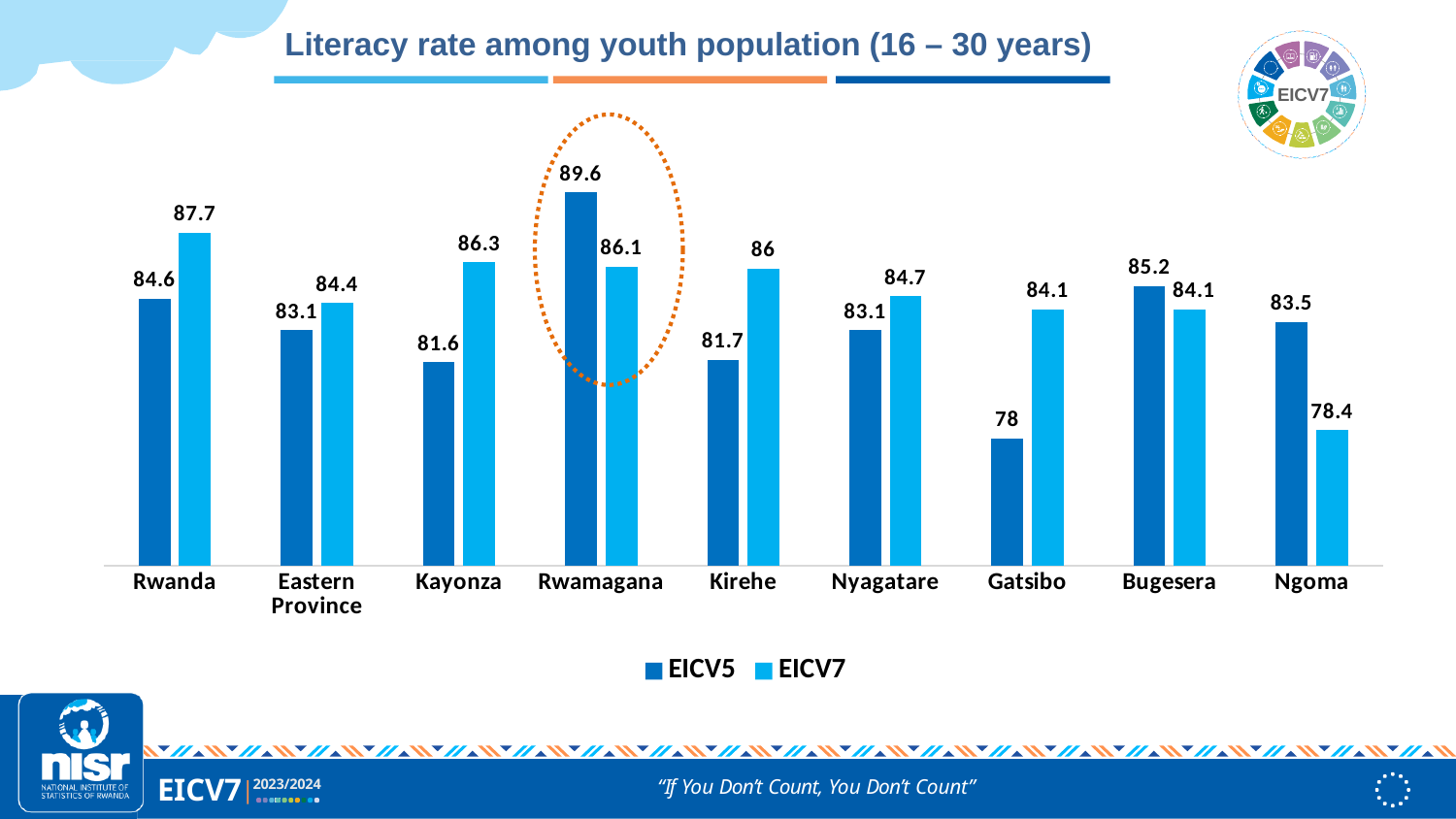
Which category is highlighted with a dotted orange circle? Rwamagana How many categories are shown on the x axis? 9 What is the difference between the EICV5 and EICV7 values for Rwamagana? 3.5 What is the EICV5 literacy rate for Gatsibo? 78 What is the EICV7 literacy rate for Rwanda? 87.7 Which category has the highest EICV5 value? Rwamagana How many series does the legend list? 2 What kind of chart is shown on the slide? Bar chart What is the difference between the EICV7 and EICV5 values for Kayonza? 4.7 Which category has the lowest EICV7 value? Ngoma Which is larger for Bugesera, the EICV5 value or the EICV7 value? EICV5 What is the EICV7 value for Kirehe? 86